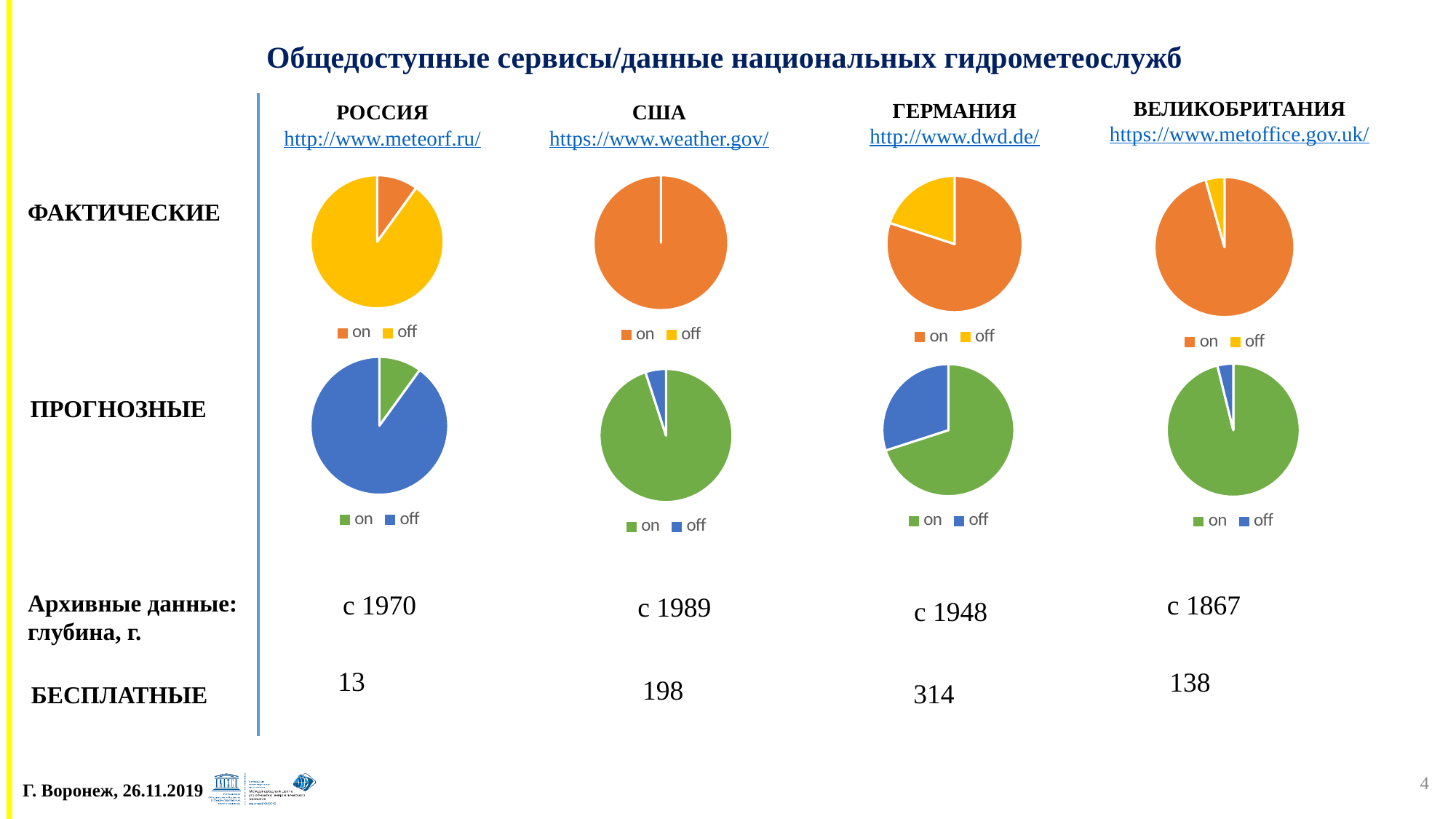
How many categories does the legend of the ФАКТИЧЕСКИЕ pie chart under ГЕРМАНИЯ show? 2 How many entries does the legend list for the ПРОГНОЗНЫЕ pie chart under США? 2 In the ПРОГНОЗНЫЕ pie chart under ГЕРМАНИЯ, which slice is larger, on or off? on In the ПРОГНОЗНЫЕ pie chart under РОССИЯ, which slice is larger, on or off? off What kind of chart is used for the ФАКТИЧЕСКИЕ row under РОССИЯ? pie chart In the ФАКТИЧЕСКИЕ pie chart under РОССИЯ, which slice is larger, on or off? off What colour represents 'on' in the ПРОГНОЗНЫЕ pie charts? green What colour represents 'off' in the ФАКТИЧЕСКИЕ pie charts? yellow How many pie charts are shown on the slide in total? 8